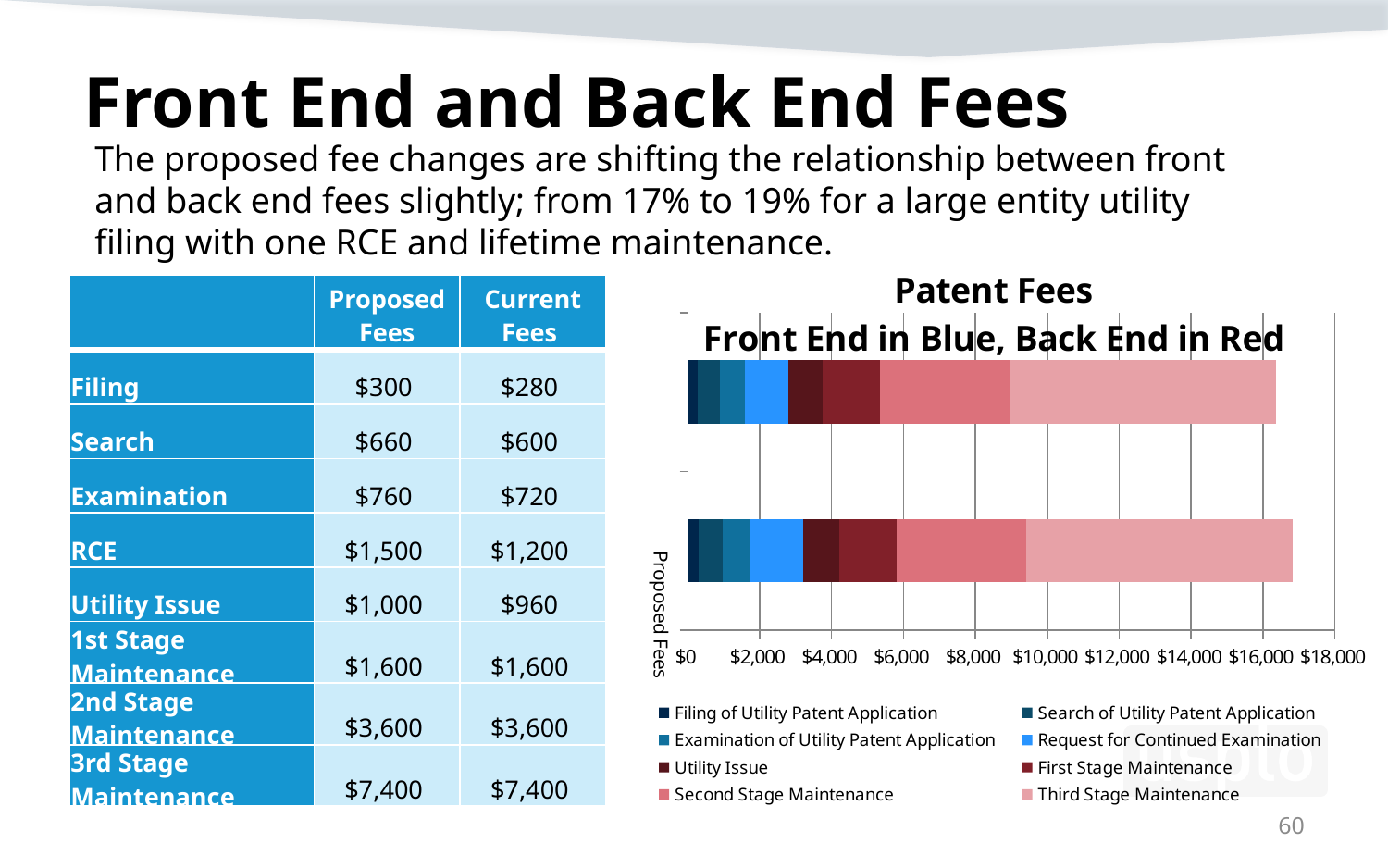
In the Patent Fees chart, which bar is longer: the Proposed Fees bar or the top bar? Proposed Fees How many series does the legend of the Patent Fees chart list? 8 According to the subtitle of the Patent Fees chart, what colour are the back end fees shown in? Red In the Patent Fees chart, is the total of the top bar greater or less than $18,000? less How many bars are plotted in the Patent Fees chart? 2 What kind of chart is shown under the title "Patent Fees"? Stacked bar chart In the Patent Fees chart, is the total of the top bar greater or less than $14,000? greater In the Patent Fees chart, is the total of the Proposed Fees bar greater or less than $18,000? less What is the highest tick label on the x axis of the Patent Fees chart? $18,000 In the Patent Fees chart, which series forms the largest segment of the Proposed Fees bar? Third Stage Maintenance